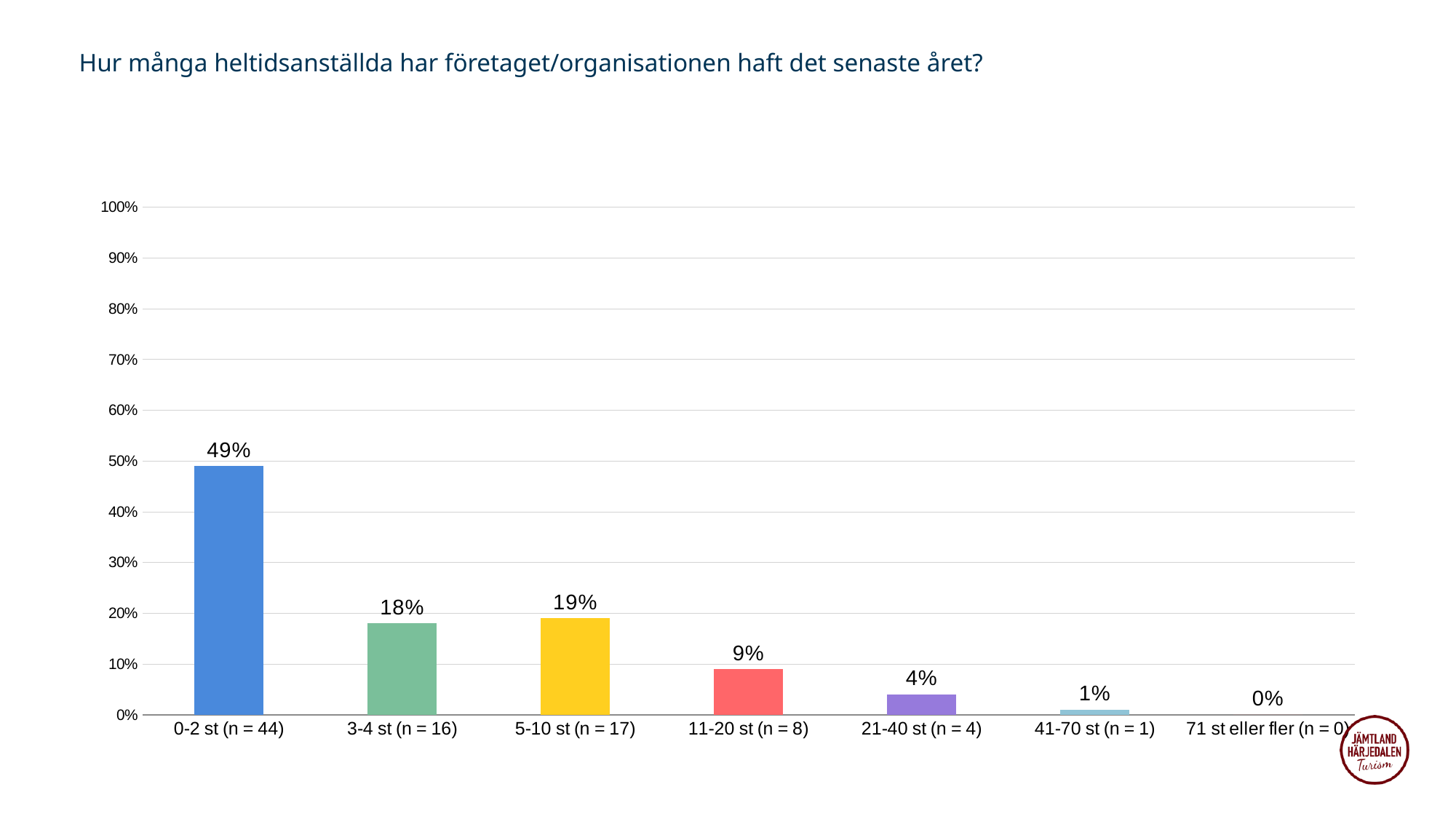
Which category has the highest value? 0-2 st (n = 44) Is the value for "0-2 st (n = 44)" greater or less than 40%? greater What is the value for the "0-2 st (n = 44)" category? 49% What is the title of the chart? Hur många heltidsanställda har företaget/organisationen haft det senaste året? Which is larger, the value for "11-20 st (n = 8)" or the value for "21-40 st (n = 4)"? 11-20 st (n = 8) What is the value for the "41-70 st (n = 1)" category? 1% What is the value for the "21-40 st (n = 4)" category? 4% What kind of chart is shown on the slide? bar chart What is the value for the "5-10 st (n = 17)" category? 19% How many categories are shown on the x axis? 7 What is the difference between the values for "0-2 st (n = 44)" and "3-4 st (n = 16)"? 31% Which category has the lowest value? 71 st eller fler (n = 0)